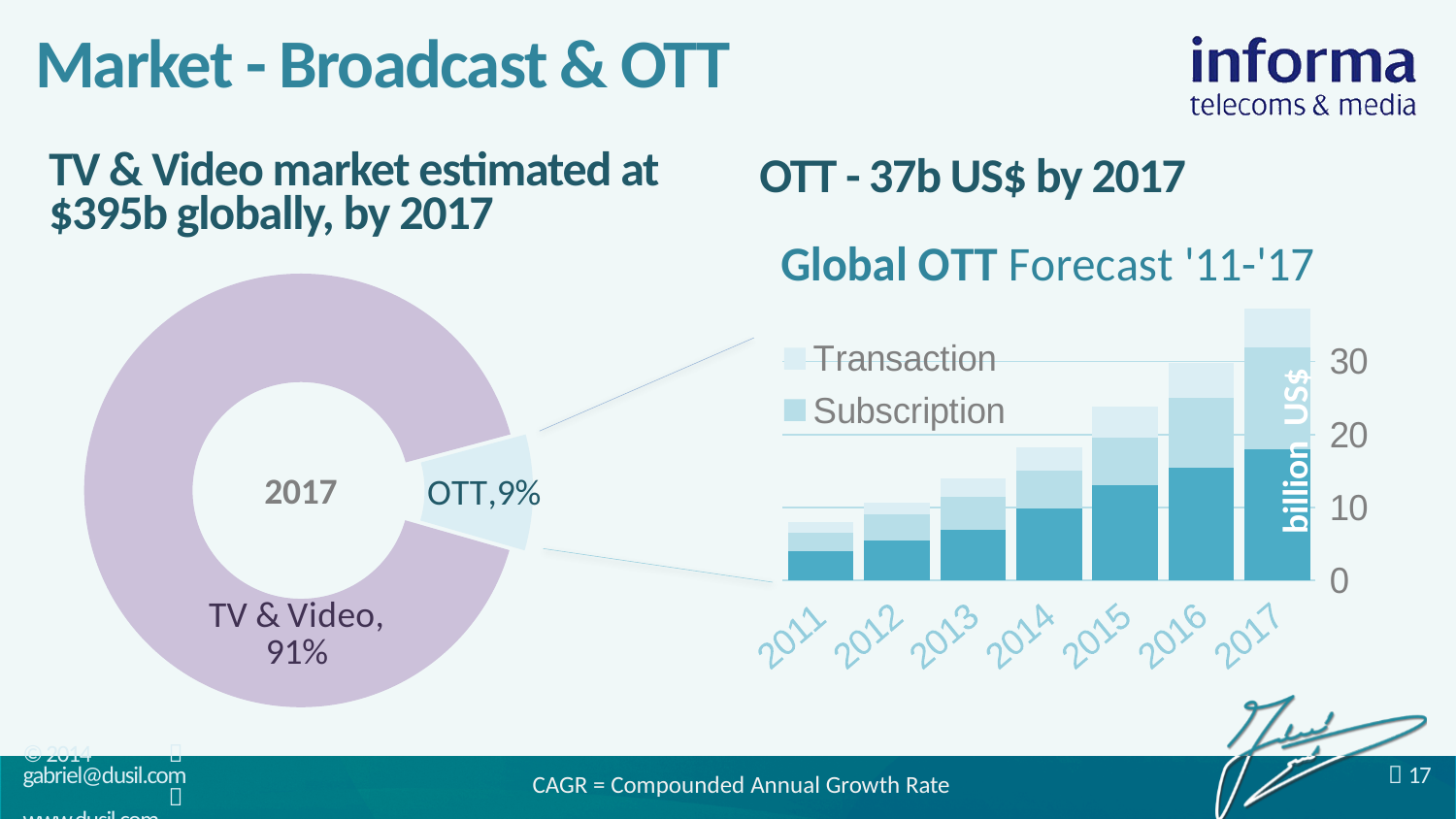
In the Global OTT Forecast chart, do the total bar heights rise or fall from 2011 to 2017? Rise On the donut chart on the left, what share of the 2017 market is OTT? 9% What kind of chart is the Global OTT Forecast chart? Stacked bar chart In the Global OTT Forecast chart, which year has the lowest total bar? 2011 How many years are shown on the x axis of the Global OTT Forecast chart? 7 On the donut chart on the left, which segment is larger, OTT or TV & Video? TV & Video How many series does the legend of the Global OTT Forecast chart list? 2 In the Global OTT Forecast chart, which year has the highest total bar? 2017 On the donut chart on the left, what share of the 2017 market is TV & Video? 91% What kind of chart is the chart on the left of the slide? Pie (donut) chart In the Global OTT Forecast chart, is the total value for 2017 greater or less than 30? greater In the Global OTT Forecast chart, is the total value for 2011 greater or less than 10? less